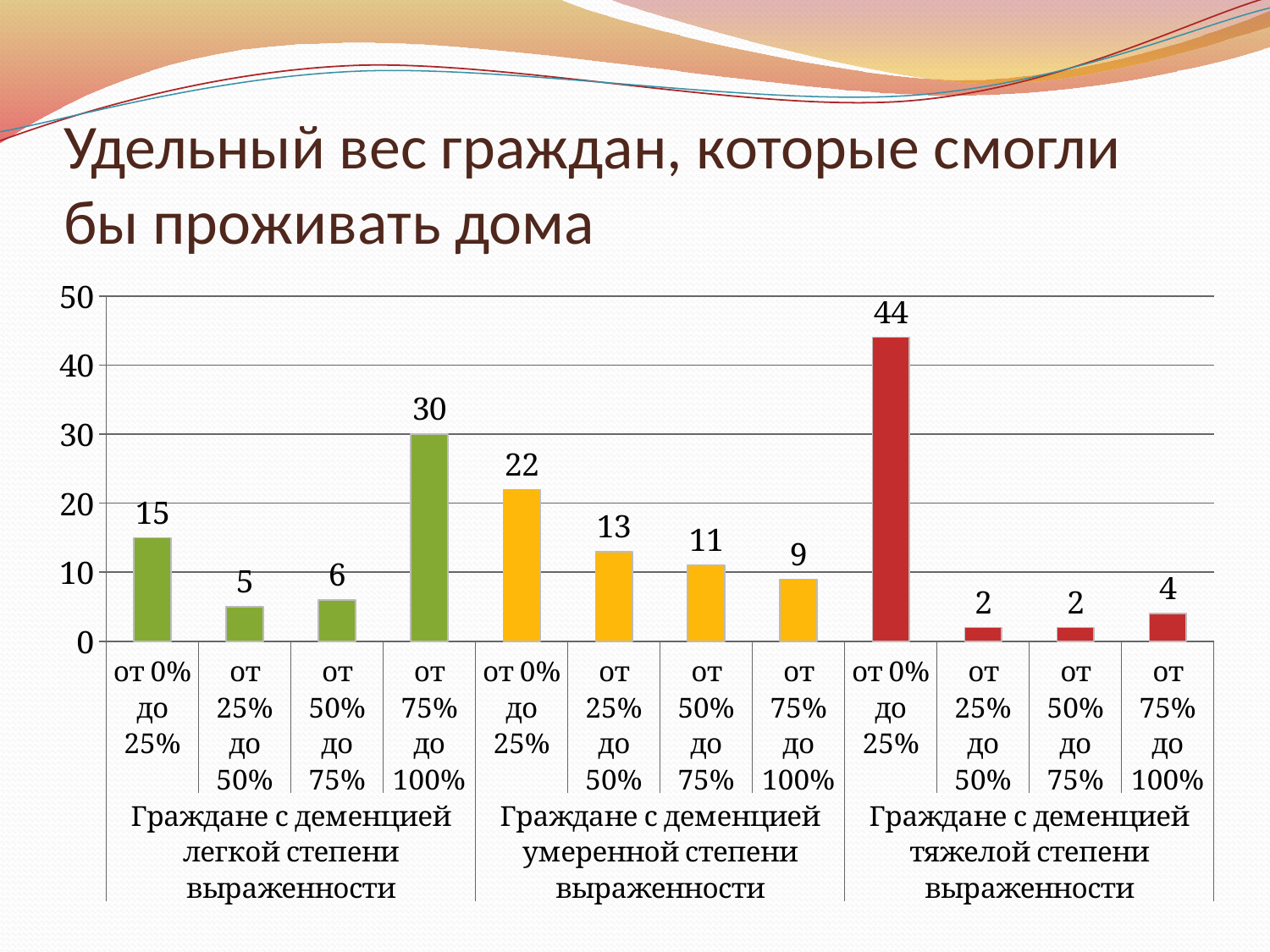
How many dementia severity groups are shown on the x axis? 3 What is the difference between the 'от 0% до 25%' bar in the severe dementia group (тяжелой степени) and the 'от 0% до 25%' bar in the mild dementia group (легкой степени)? 29 What is the title of the chart on the slide? Удельный вес граждан, которые смогли бы проживать дома What is the value for the 'от 0% до 25%' bar in the 'Граждане с деменцией тяжелой степени выраженности' group? 44 Within the 'Граждане с деменцией умеренной степени выраженности' group, do the values rise or fall from 'от 0% до 25%' to 'от 75% до 100%'? Fall Which is larger: the 'от 75% до 100%' bar in the mild dementia group (легкой степени) or the 'от 0% до 25%' bar in the moderate dementia group (умеренной степени)? от 75% до 100% in the mild dementia group (30) Which bar has the highest value on the chart? от 0% до 25%, Граждане с деменцией тяжелой степени выраженности What kind of chart is shown on the slide? Bar chart What is the value for the 'от 75% до 100%' bar in the 'Граждане с деменцией легкой степени выраженности' group? 30 How many bars are plotted on the chart? 12 What is the value for the 'от 50% до 75%' bar in the 'Граждане с деменцией умеренной степени выраженности' group? 11 What is the lowest value shown on the chart? 2